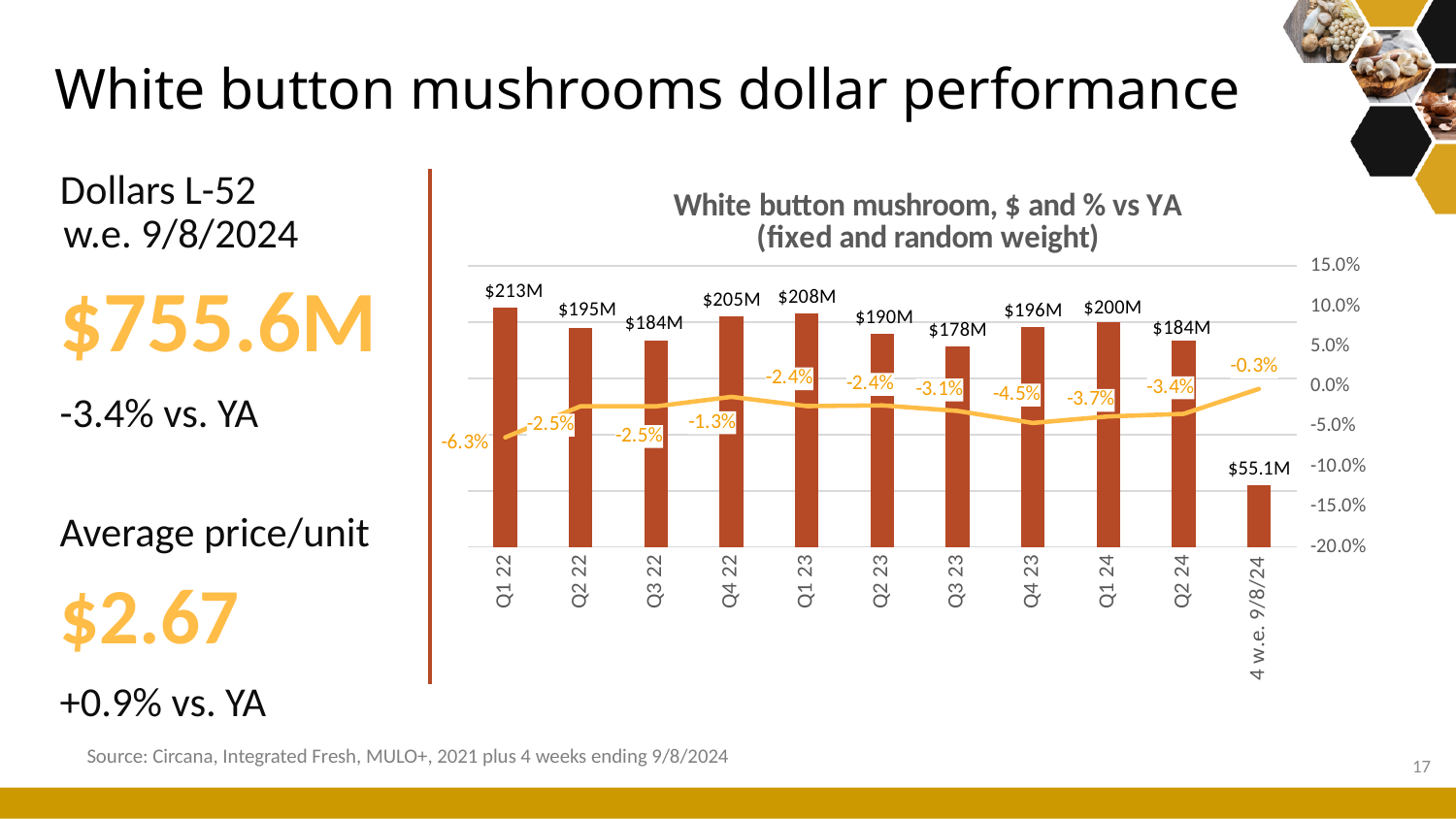
What is the % vs YA value shown for Q1 22? -6.3% What is the dollar value shown for Q1 22? $213M How many categories are shown on the x axis of the chart? 11 What is the % vs YA value shown for Q4 23? -4.5% What kind of chart is shown on the slide? Combination bar and line chart Which quarter has the lowest dollar value among the quarterly bars? Q3 23 What is the % vs YA value shown for Q2 24? -3.4% Which has a higher dollar value, Q4 22 or Q2 23? Q4 22 Which quarter has the highest dollar value among the quarterly bars? Q1 22 What is the dollar value shown for the 4 w.e. 9/8/24 bar? $55.1M What is the difference in dollar value between Q1 23 and Q3 23? $30M What is the title of the chart? White button mushroom, $ and % vs YA (fixed and random weight)